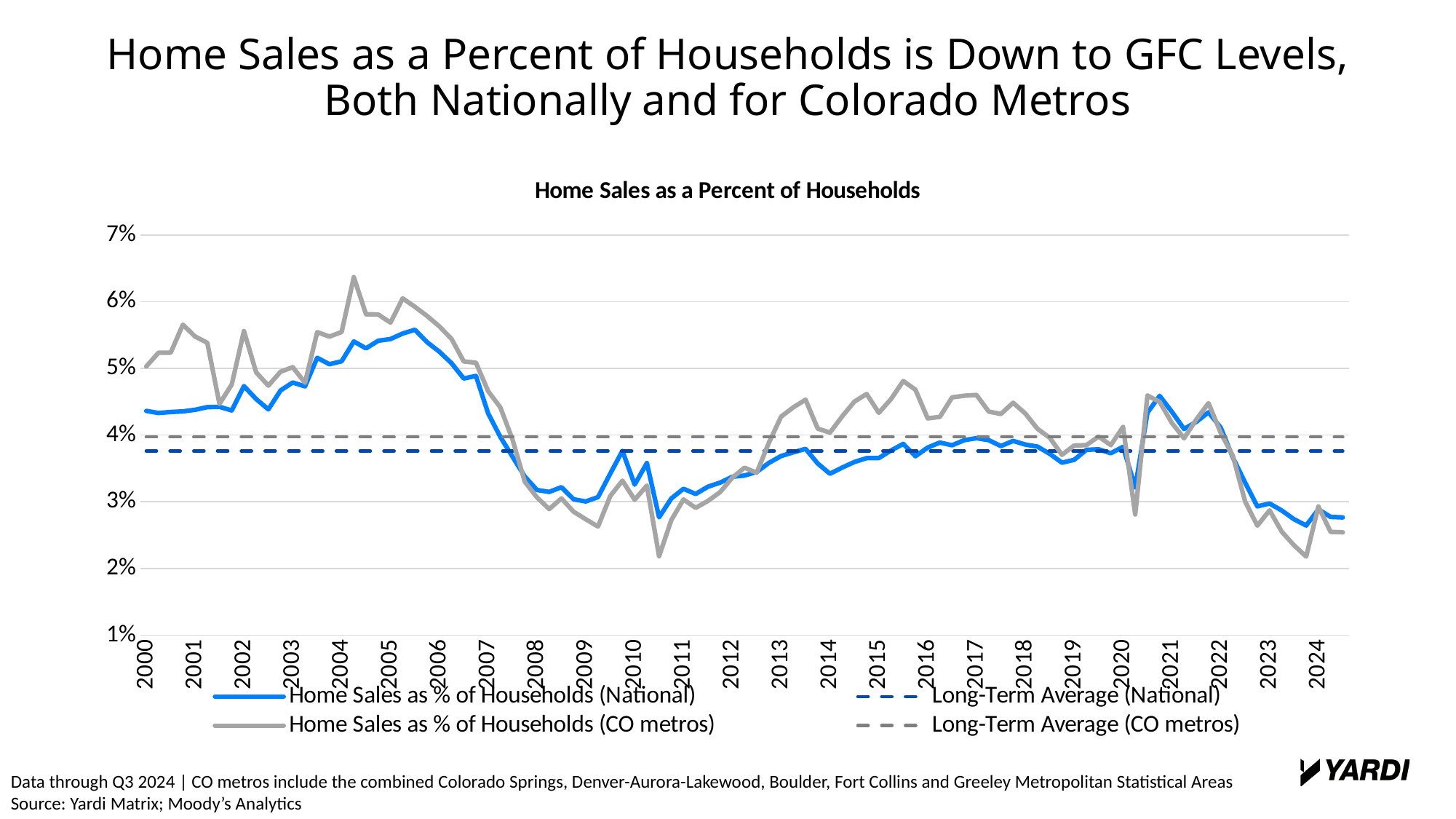
How many series does the chart legend list? 4 Which series reaches the highest value anywhere on the chart? Home Sales as % of Households (CO metros) What kind of chart is shown on the slide? line chart Is the National value at the end of the series in 2024 greater or less than 3%? less Does the National line rise or fall between 2021 and 2024? fall Is the peak value of the CO metros line around 2004 greater or less than 6%? greater Is the peak value of the National line around 2005 greater or less than 6%? less Which is higher, the Long-Term Average (National) or the Long-Term Average (CO metros)? Long-Term Average (CO metros) What is the title of the chart? Home Sales as a Percent of Households Which colour is used for the Home Sales as % of Households (National) line? blue Around 2014, which line is higher, National or CO metros? CO metros